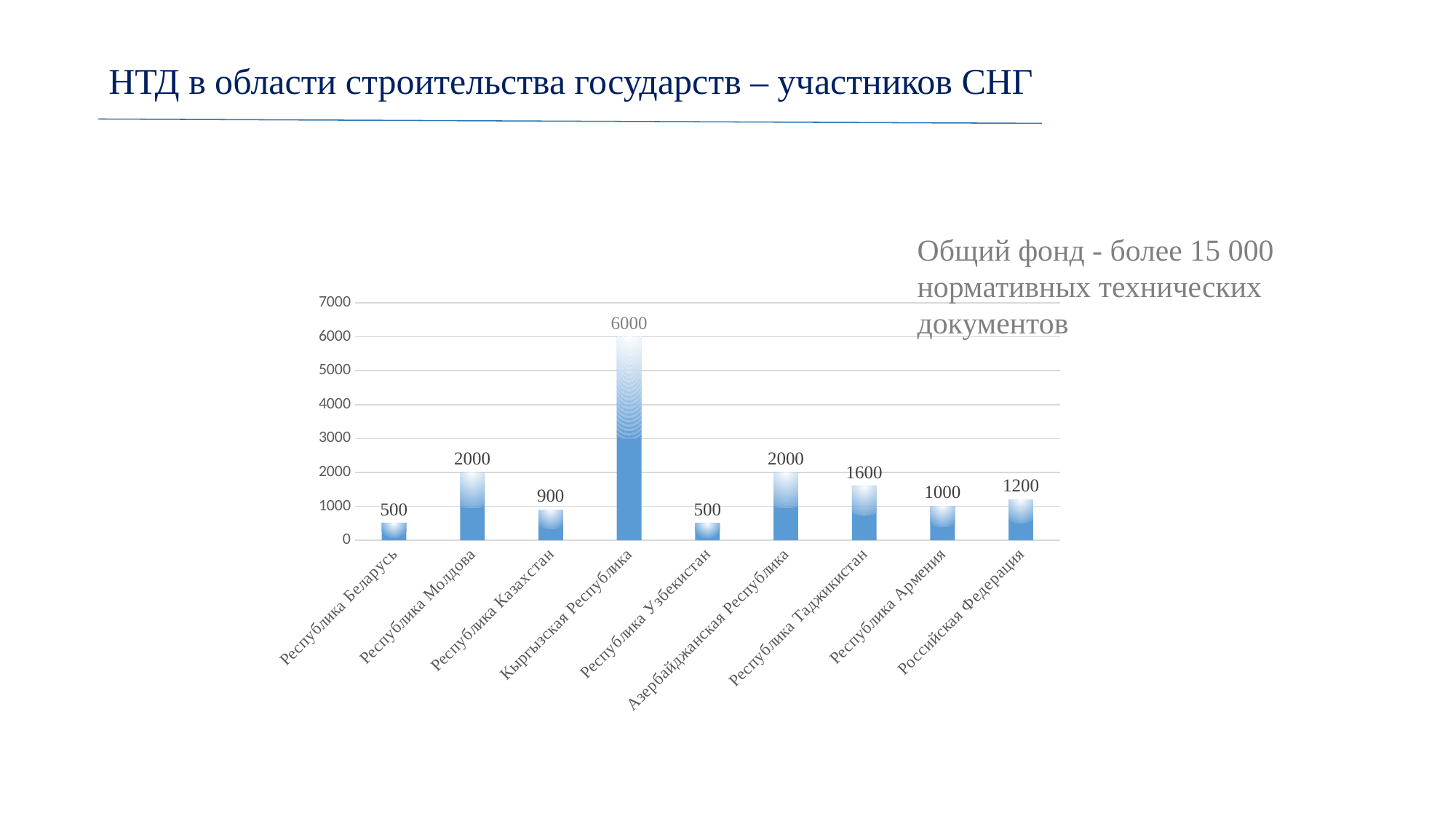
What is the value for Республика Таджикистан? 1600 Is the value for Азербайджанская Республика greater or less than 1000? greater Which is larger, the value for Республика Армения or the value for Российская Федерация? Российская Федерация What is the value for Кыргызская Республика? 6000 What is the highest tick value shown on the vertical axis? 7000 How many categories are shown on the x axis? 9 Which category has the highest value? Кыргызская Республика What is the value for Республика Узбекистан? 500 What is the difference between the values for Республика Молдова and Республика Казахстан? 1100 What kind of chart is shown on the slide? bar chart What is the value for Российская Федерация? 1200 What is the difference between the values for Кыргызская Республика and Республика Беларусь? 5500